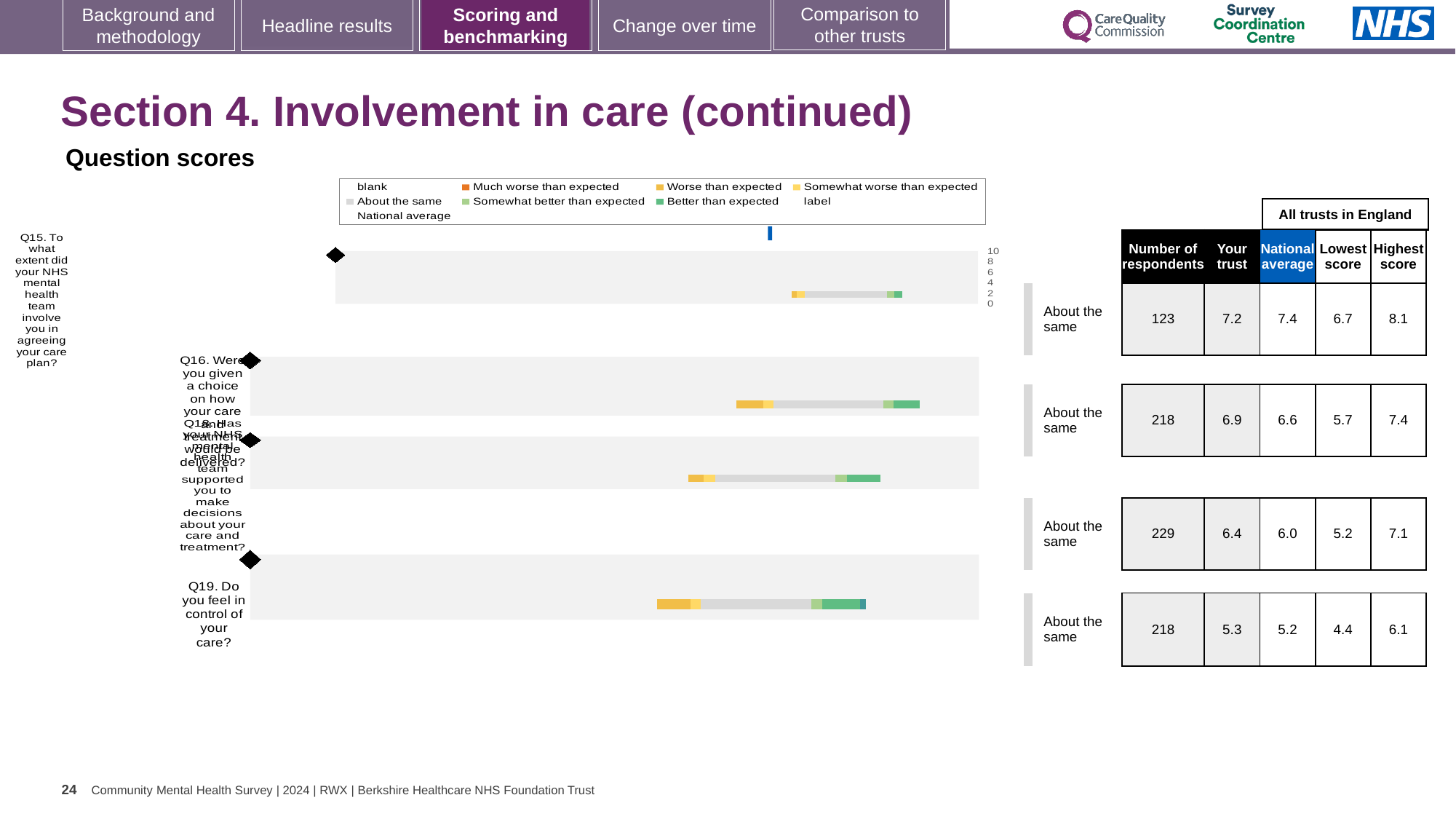
In the table beside the chart, what is the difference between the highest score and the lowest score for Q16? 1.7 In the table beside the chart, which question has the highest 'Your trust' score? Q15 In the table beside the chart, what is the 'Your trust' score for Q15 (involvement in agreeing your care plan)? 7.2 In the table beside the chart, what is the national average for Q19 (feeling in control of your care)? 5.2 How many questions (categories) are plotted in the question scores chart? 4 In the table beside the chart, is the 'Your trust' score for Q18 higher or lower than the national average for Q18? higher In the table beside the chart, how many respondents answered Q18? 229 What kind of chart is used to show the question scores on this slide? bar chart In the table beside the chart, what is the difference between the 'Your trust' score and the national average for Q15? 0.2 In the table beside the chart, which question has the lowest 'Your trust' score? Q19 What is the heading above the 'National average', 'Lowest score' and 'Highest score' columns in the table beside the chart? All trusts in England What benchmark category is shown next to the chart for each of the four questions? About the same